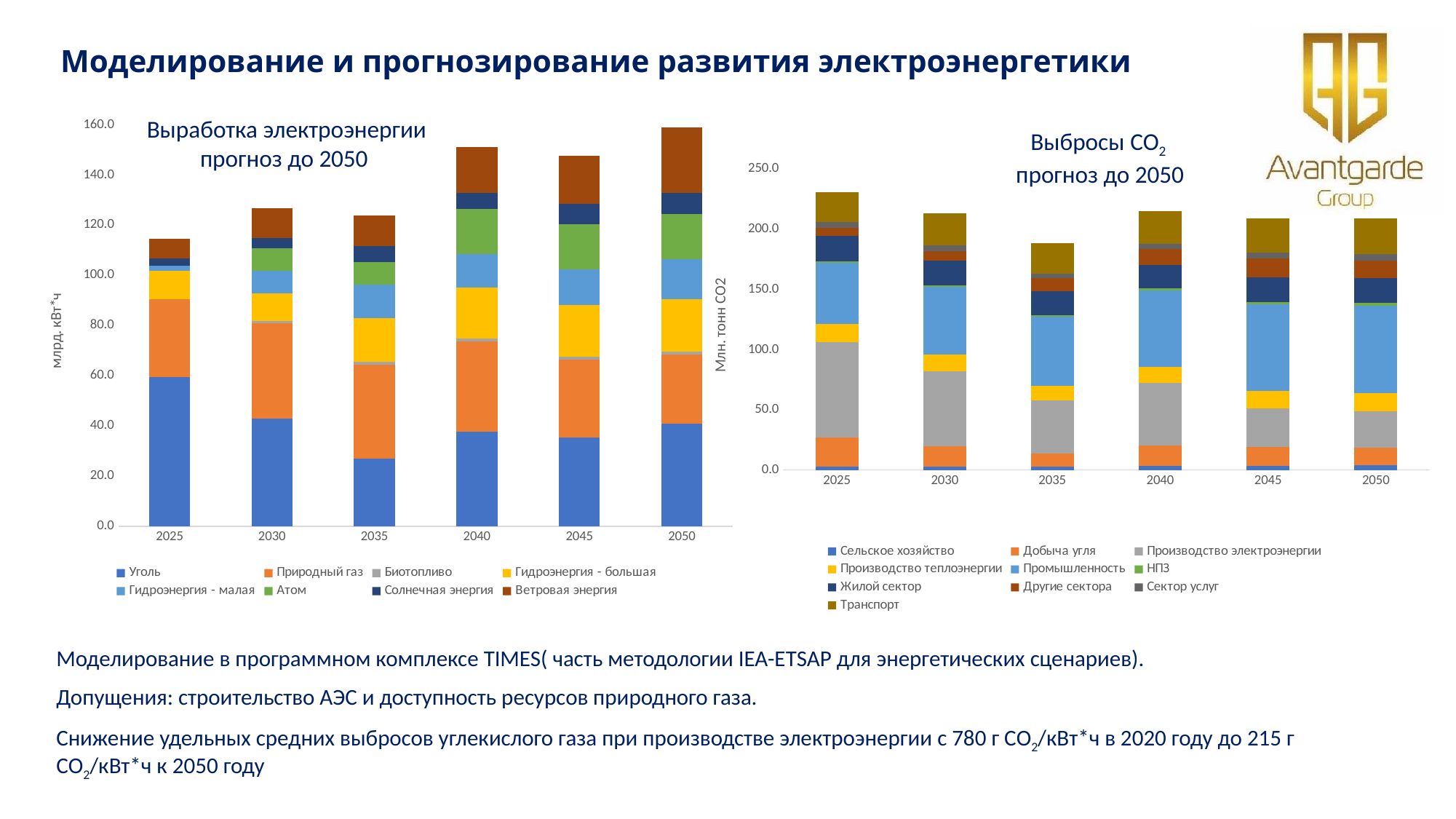
How many series does the legend of the right chart 'Выбросы CO2 прогноз до 2050' list? 10 In the right chart 'Выбросы CO2 прогноз до 2050', which year has the shortest total bar? 2035 How many years (categories) are shown on the x axis of the left chart 'Выработка электроэнергии прогноз до 2050'? 6 How many series does the legend of the left chart 'Выработка электроэнергии прогноз до 2050' list? 8 In the right chart 'Выбросы CO2 прогноз до 2050', is the total bar for 2035 greater or less than 200.0? less In the left chart 'Выработка электроэнергии прогноз до 2050', which year has the shortest total bar? 2025 In the left chart 'Выработка электроэнергии прогноз до 2050', which year has the tallest total bar? 2050 In the right chart 'Выбросы CO2 прогноз до 2050', which total bar is larger: 2025 or 2035? 2025 What is the y-axis label of the left chart 'Выработка электроэнергии прогноз до 2050'? млрд. кВт*ч What kind of chart is the left chart titled 'Выработка электроэнергии прогноз до 2050'? Stacked bar chart In the left chart 'Выработка электроэнергии прогноз до 2050', is the total bar for 2050 greater or less than 140.0? greater In the right chart 'Выбросы CO2 прогноз до 2050', which year has the tallest total bar? 2025